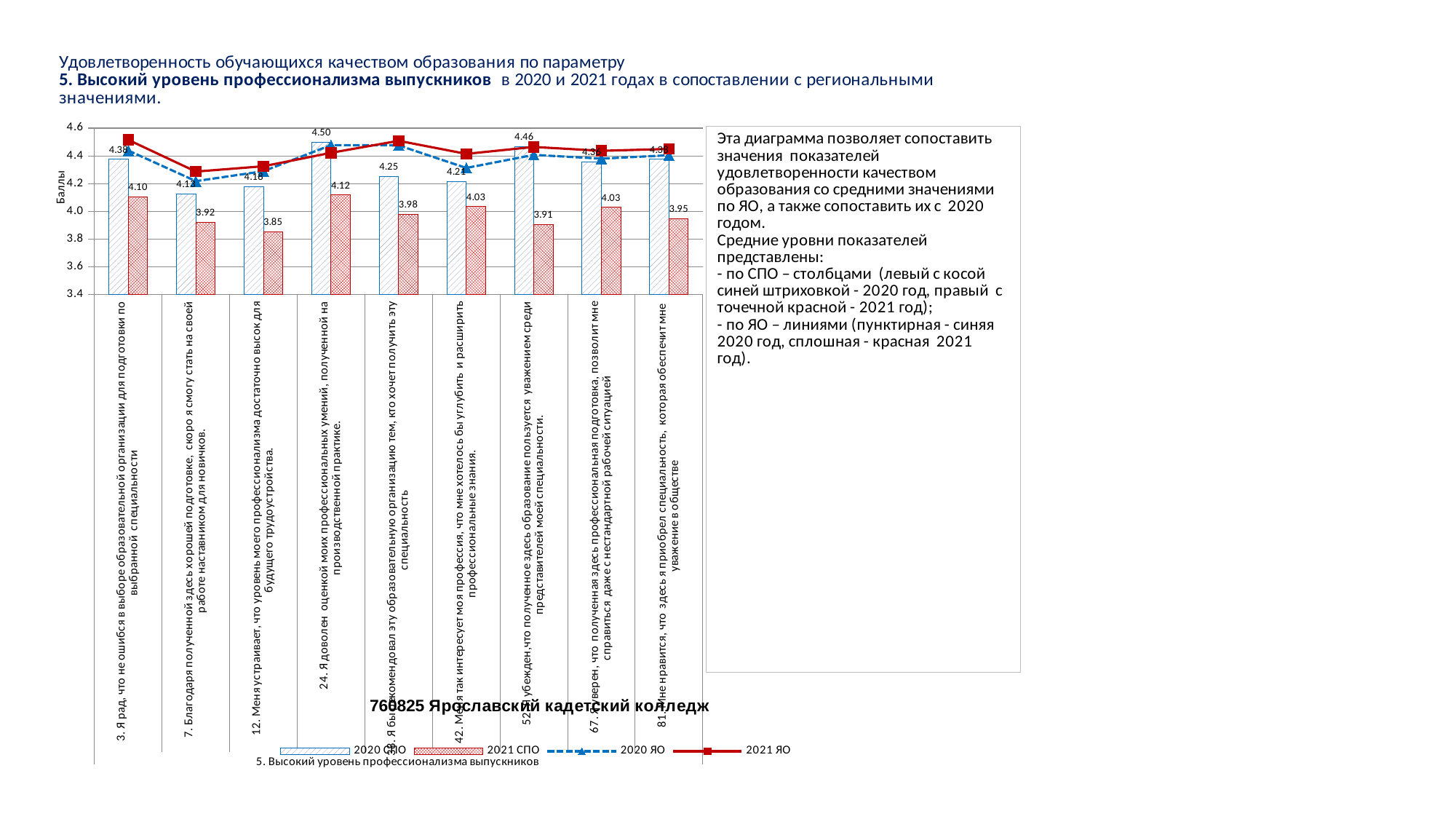
What is the difference between the 2020 СПО and 2021 СПО values for the category "52. Я убежден, что полученное здесь образование пользуется уважением среди представителей моей специальности."? 0.55 What is the label of the vertical axis of the chart? Баллы What is the value of the 2020 СПО bar for the category "24. Я доволен оценкой моих профессиональных умений, полученной на производственной практике."? 4.50 What is the value of the 2021 СПО bar for the category "52. Я убежден, что полученное здесь образование пользуется уважением среди представителей моей специальности."? 3.91 What is the value of the 2021 СПО bar for the category "12. Меня устраивает, что уровень моего профессионализма достаточно высок для будущего трудоустройства."? 3.85 Which category has the lowest 2021 СПО bar? 12. Меня устраивает, что уровень моего профессионализма достаточно высок для будущего трудоустройства. What is the difference between the 2020 СПО and 2021 СПО values for the category "24. Я доволен оценкой моих профессиональных умений, полученной на производственной практике."? 0.38 How many series does the chart legend list? 4 For the category "38. Я бы рекомендовал эту образовательную организацию тем, кто хочет получить эту специальность", which is larger: the 2020 СПО value or the 2021 СПО value? 2020 СПО How many categories are shown on the x axis of the chart? 9 Which category has the highest 2020 СПО bar? 24. Я доволен оценкой моих профессиональных умений, полученной на производственной практике. Is the 2021 ЯО line value for the first category ("3. Я рад, что не ошибся в выборе образовательной организации...") greater or less than 4.4? greater